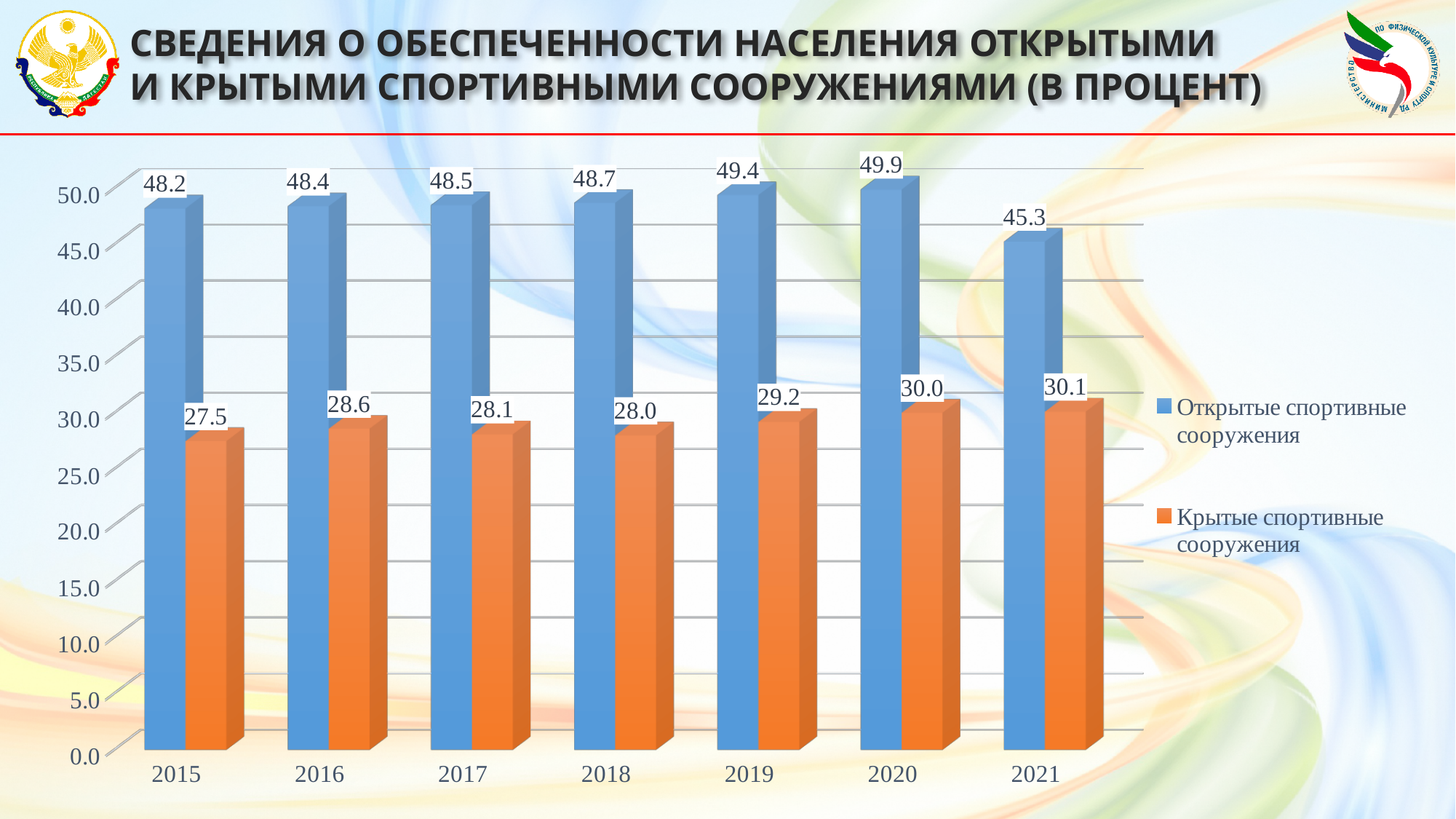
How many years are shown on the x axis? 7 In which year is the value for Открытые спортивные сооружения highest? 2020 What kind of chart is shown on the slide? bar chart What is the value for Крытые спортивные сооружения in 2016? 28.6 What is the value for Открытые спортивные сооружения in 2019? 49.4 Is the value for Крытые спортивные сооружения in 2021 greater or less than 25.0? greater Does the value for Крытые спортивные сооружения rise or fall from 2018 to 2021? rise What colour are the bars for Крытые спортивные сооружения? orange In which year is the value for Крытые спортивные сооружения lowest? 2015 What is the difference between the Открытые спортивные сооружения value in 2020 and in 2021? 4.6 How many series does the legend list? 2 Which is larger in 2018: the value for Открытые спортивные сооружения or for Крытые спортивные сооружения? Открытые спортивные сооружения